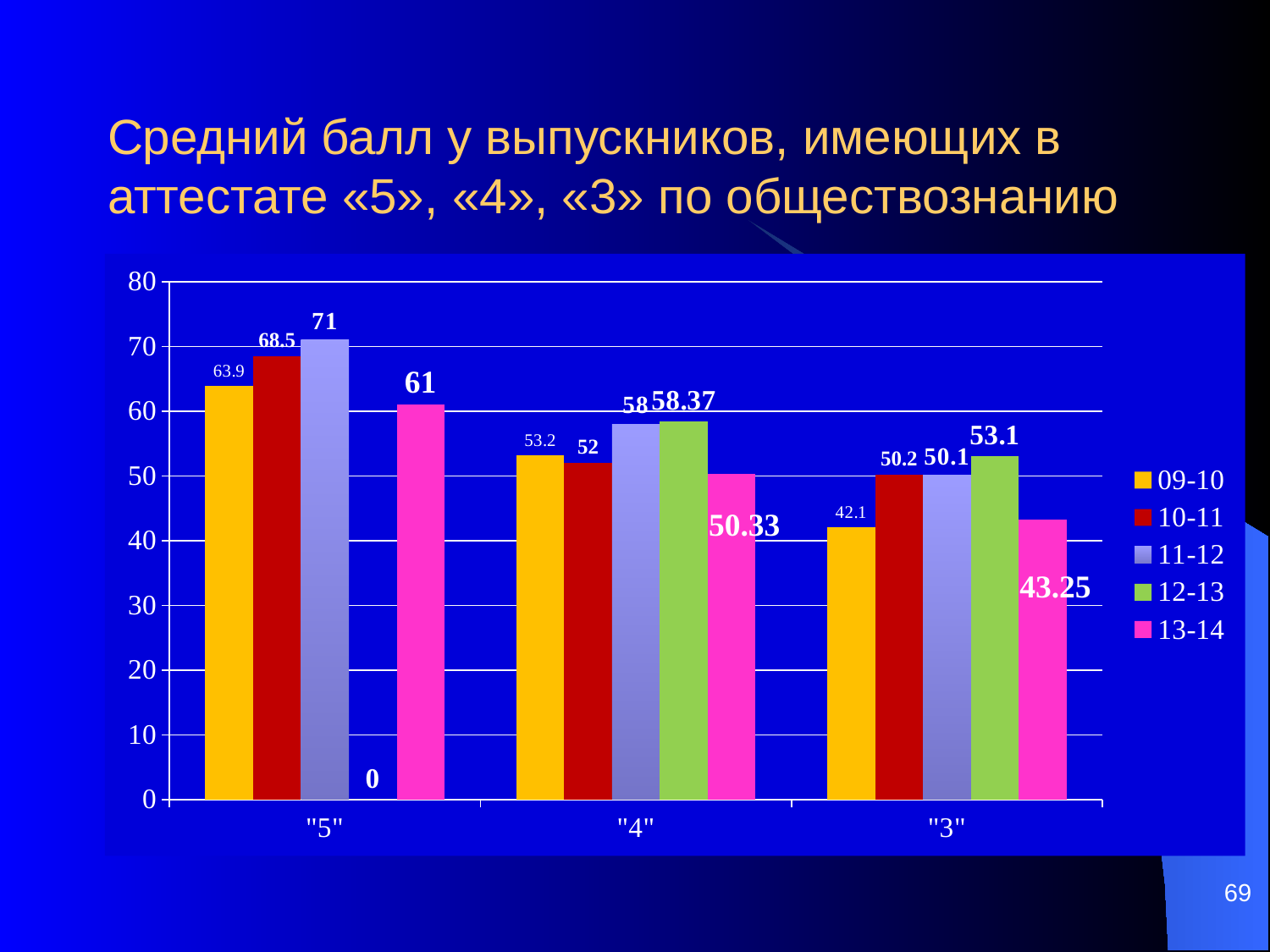
What is the value for series 11-12 in category "5"? 71 Which series has the lowest value in category "4"? 13-14 What type of chart is shown on the slide? bar chart How many categories are shown on the x axis? 3 What is the difference between the 10-11 and 09-10 values in category "5"? 4.6 Which is larger in category "3": the value for 10-11 or the value for 13-14? 10-11 Which series is shown in pink in the legend? 13-14 What is the value for series 12-13 in category "5"? 0 Which series has the highest value in category "3"? 12-13 How many series does the legend list? 5 What is the value for series 09-10 in category "3"? 42.1 What is the value for series 13-14 in category "4"? 50.33